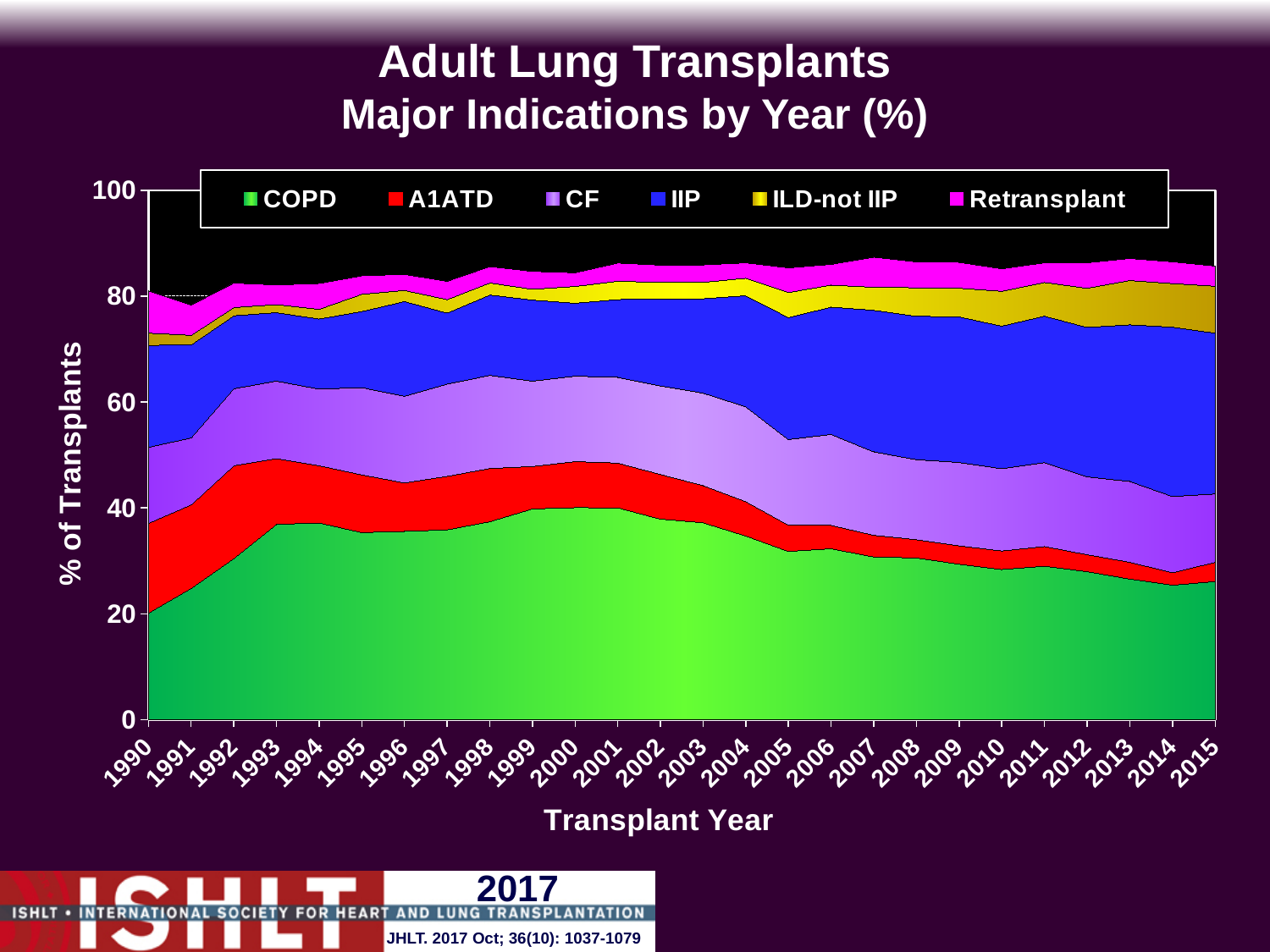
What kind of chart is shown on the slide? Stacked area chart Is the combined share of all six indications in 2015 greater or less than 80? greater Does the COPD share of transplants rise or fall from 1990 to 2000? rise What is the last transplant year shown on the x axis? 2015 Is the COPD share of transplants in 1990 greater or less than 40? less How many transplant years are plotted along the x axis? 26 Is the COPD share of transplants larger in 2000 or in 2015? 2000 What is the first transplant year shown on the x axis? 1990 Which indication has the largest share of transplants in 2000? COPD Does the COPD share of transplants rise or fall from 2000 to 2015? fall How many series does the legend list? 6 Is the COPD share of transplants in 2000 greater or less than 20? greater